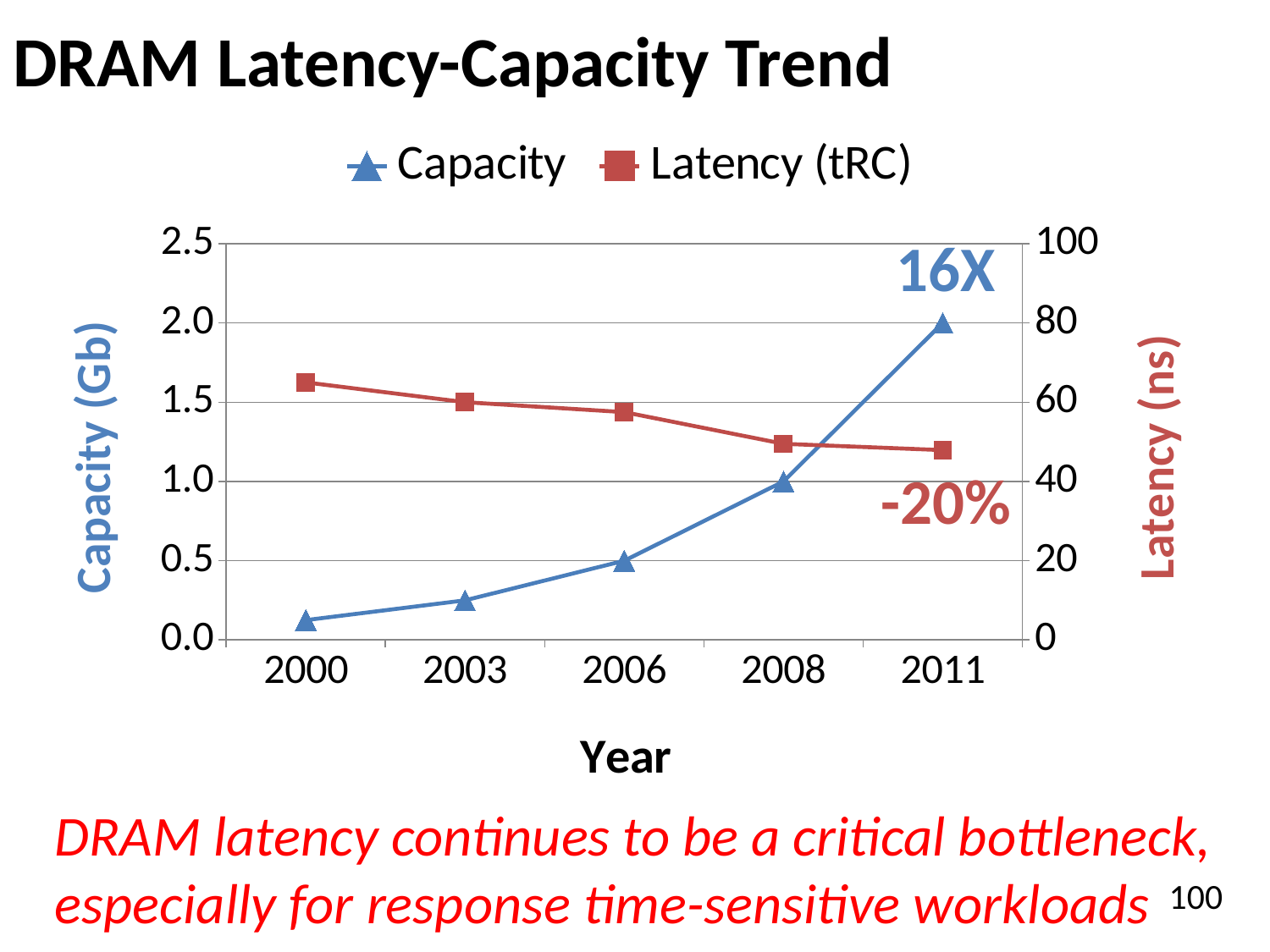
Which year has the highest Capacity? 2011 Is the Capacity value for 2000 greater or less than 0.5? less What is the title of the x axis? Year What is the Capacity value for 2008? 1.0 Is the Latency (tRC) value for 2000 greater or less than 60? greater Does the Capacity series rise or fall from 2000 to 2011? rise How many years are plotted along the x axis? 5 How many series does the legend list? 2 Which year has the highest Latency (tRC)? 2000 Does the Latency (tRC) series rise or fall from 2000 to 2011? fall What kind of chart is shown on the slide? line chart What is the Capacity value for 2011? 2.0